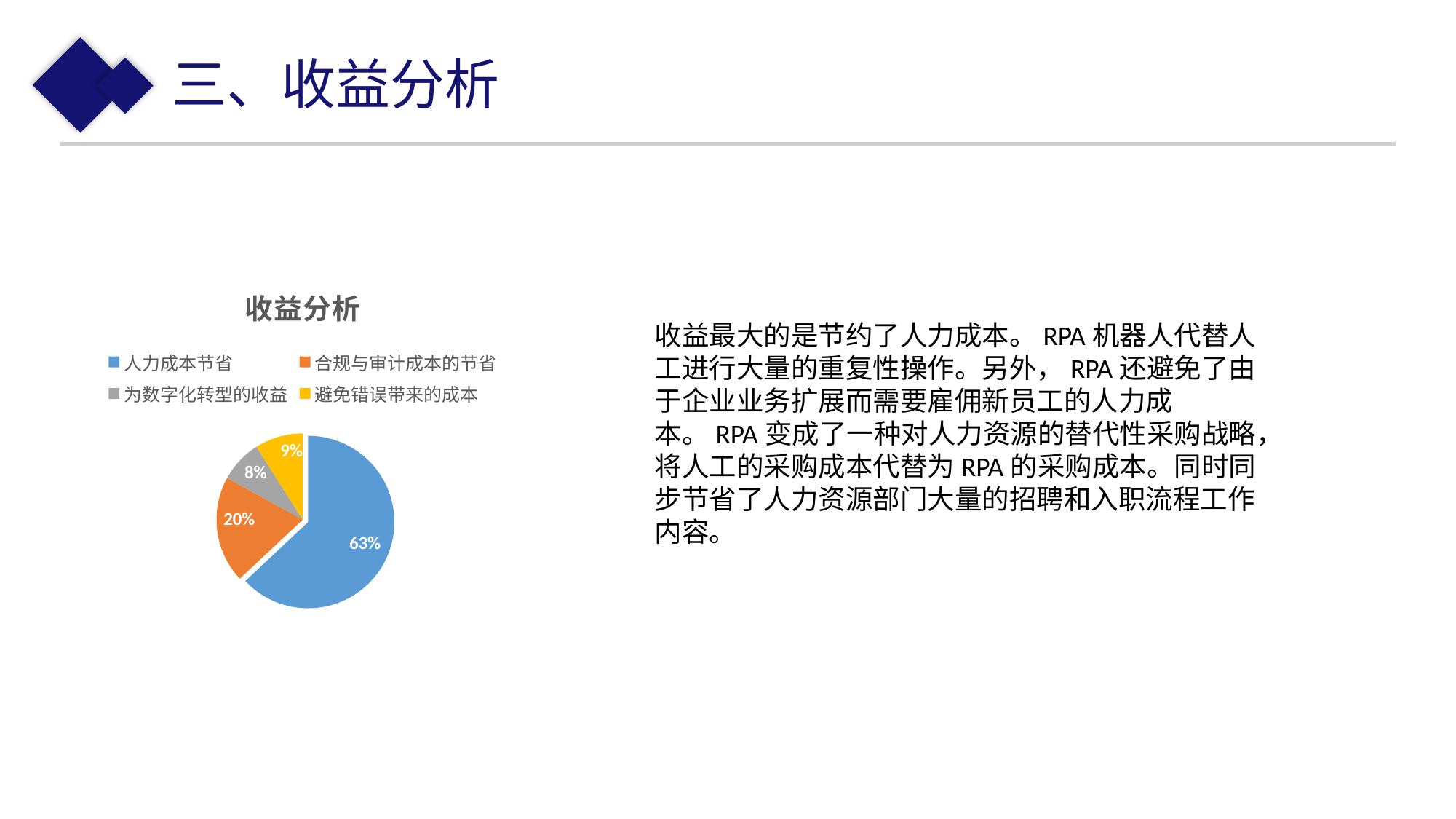
Which is larger, the share for 避免错误带来的成本 or the share for 为数字化转型的收益? 避免错误带来的成本 How many categories does the pie chart show? 4 What is the title of the chart? 收益分析 What share of the pie does 避免错误带来的成本 represent? 9% What share of the pie does 为数字化转型的收益 represent? 8% What share of the pie does 合规与审计成本的节省 represent? 20% What is the difference between the shares of 人力成本节省 and 合规与审计成本的节省? 43% Which category has the largest slice of the pie? 人力成本节省 Which category has the smallest slice of the pie? 为数字化转型的收益 What type of chart is shown on the slide? pie chart What colour is the slice for 合规与审计成本的节省? orange